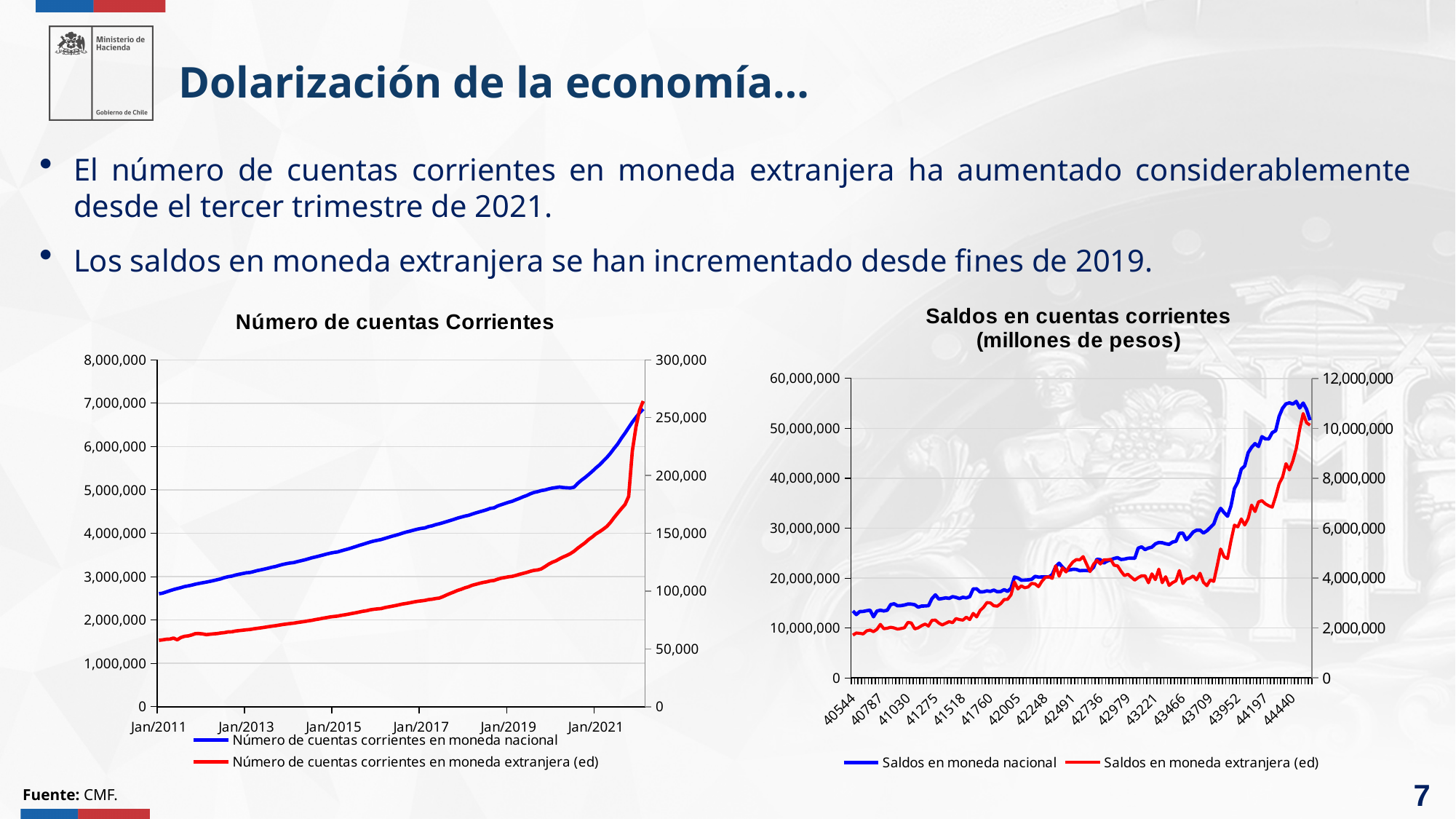
In the 'Número de cuentas Corrientes' chart, is the value of 'Número de cuentas corrientes en moneda nacional' at Jan/2011 greater or less than 2,000,000? greater In the 'Saldos en cuentas corrientes (millones de pesos)' chart, is the value of 'Saldos en moneda nacional' at the start of the period greater or less than 10,000,000? greater In the 'Número de cuentas Corrientes' chart, is the value of 'Número de cuentas corrientes en moneda extranjera (ed)' at Jan/2011 greater or less than 100,000 on the right axis? less What kind of chart is the 'Número de cuentas Corrientes' chart on the left? line chart What kind of chart is the 'Saldos en cuentas corrientes (millones de pesos)' chart on the right? line chart How many series does the legend of the 'Número de cuentas Corrientes' chart list? 2 How many series does the legend of the 'Saldos en cuentas corrientes (millones de pesos)' chart list? 2 In the 'Número de cuentas Corrientes' chart, does the 'Número de cuentas corrientes en moneda extranjera (ed)' series rise or fall over the period shown? rise In the 'Saldos en cuentas corrientes (millones de pesos)' chart, which colour is used for the 'Saldos en moneda extranjera (ed)' series? red In the 'Número de cuentas Corrientes' chart, does the 'Número de cuentas corrientes en moneda nacional' series rise or fall from Jan/2011 to the end of the period? rise